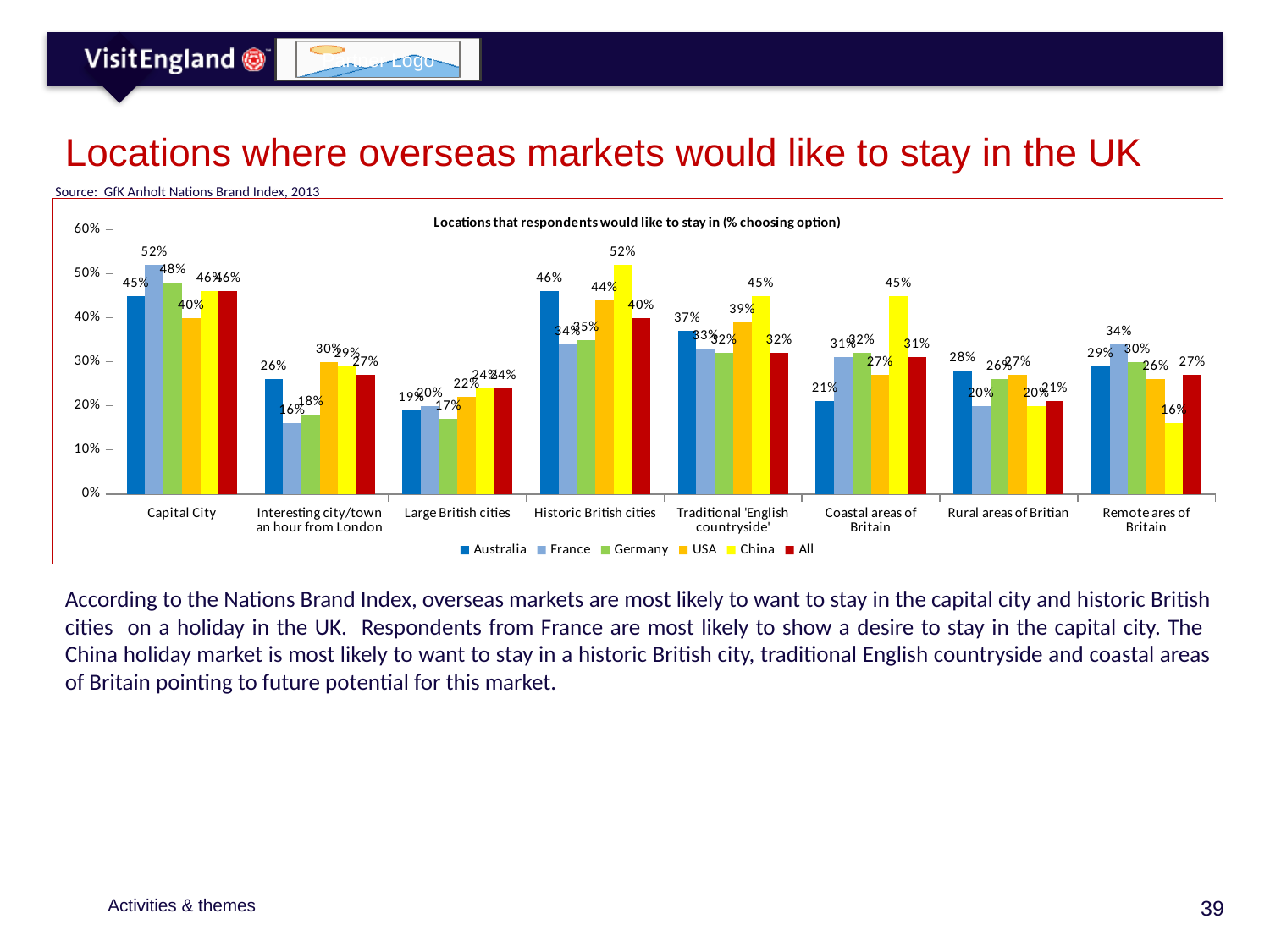
How many series does the legend list? 6 What percentage of China respondents chose Coastal areas of Britain? 45% Which market has the lowest value for Remote ares of Britain? China What is the title of the chart? Locations that respondents would like to stay in (% choosing option) For Capital City, what is the difference between the France value and the Australia value? 7 percentage points Is the Australia value for Traditional 'English countryside' greater or less than 30%? greater For Coastal areas of Britain, which is larger: the China value or the Australia value? China What percentage of France respondents chose Capital City? 52% What kind of chart is shown on the slide? Bar chart How many location categories are shown on the x axis? 8 What percentage of China respondents chose Historic British cities? 52% Which market has the highest value for Capital City? France